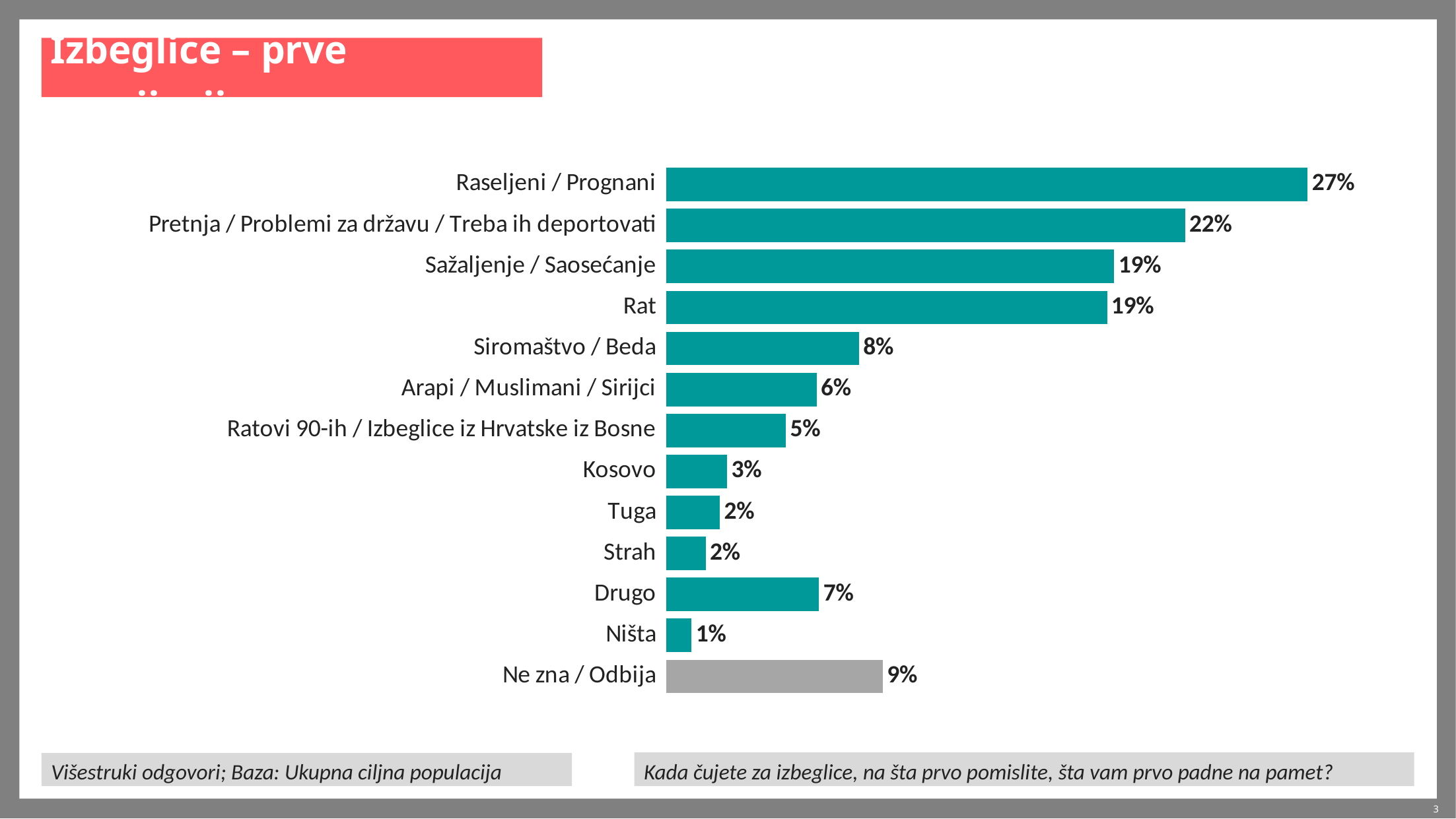
What is the value for Kosovo? 3% What is the value for Siromaštvo / Beda? 8% How many categories are shown in the chart? 13 Which bar is shown in a different colour (grey) from the others? Ne zna / Odbija Which category has the highest value? Raseljeni / Prognani What is the value for Ne zna / Odbija? 9% What is the difference between the values for Siromaštvo / Beda and Ratovi 90-ih / Izbeglice iz Hrvatske iz Bosne? 3% Which is larger, the value for Drugo or the value for Arapi / Muslimani / Sirijci? Drugo Which category has the lowest value? Ništa What kind of chart is shown on the slide? Bar chart What is the value for Raseljeni / Prognani? 27% What is the difference between the values for Raseljeni / Prognani and Pretnja / Problemi za državu / Treba ih deportovati? 5%